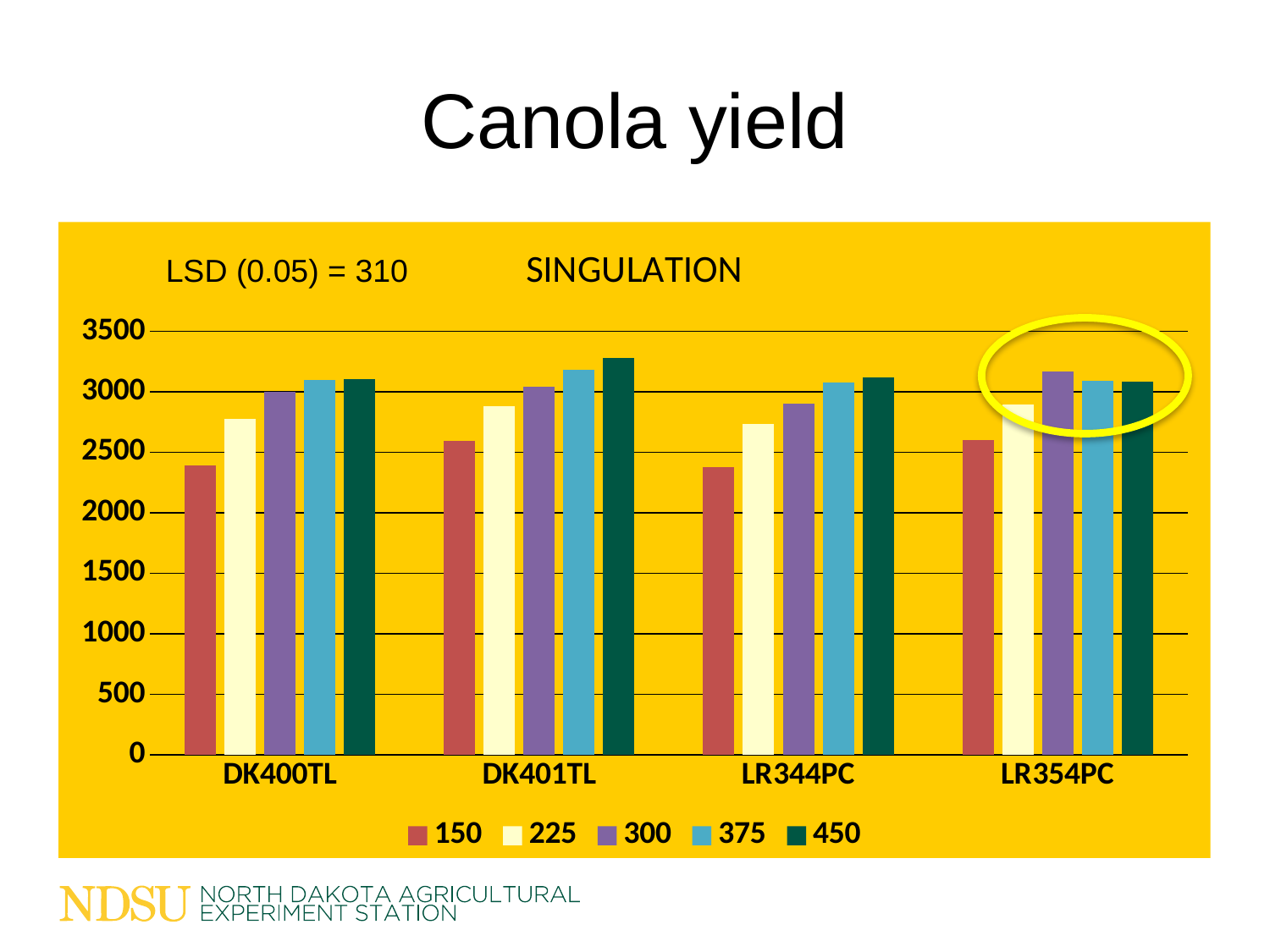
Is the value for the 225 series at LR344PC greater or less than 2500? greater How many canola varieties (categories) are shown on the x axis? 4 Is the value for the 450 series at DK401TL greater or less than 3000? greater How many series does the legend list? 5 Is the value for the 150 series at LR344PC greater or less than 2500? less For DK400TL, which series has the lowest value? 150 For DK401TL, which is larger: the 150 series or the 450 series? 450 What kind of chart is shown on the slide? bar chart What LSD (0.05) value is printed on the chart? 310 For DK401TL, which series has the highest value? 450